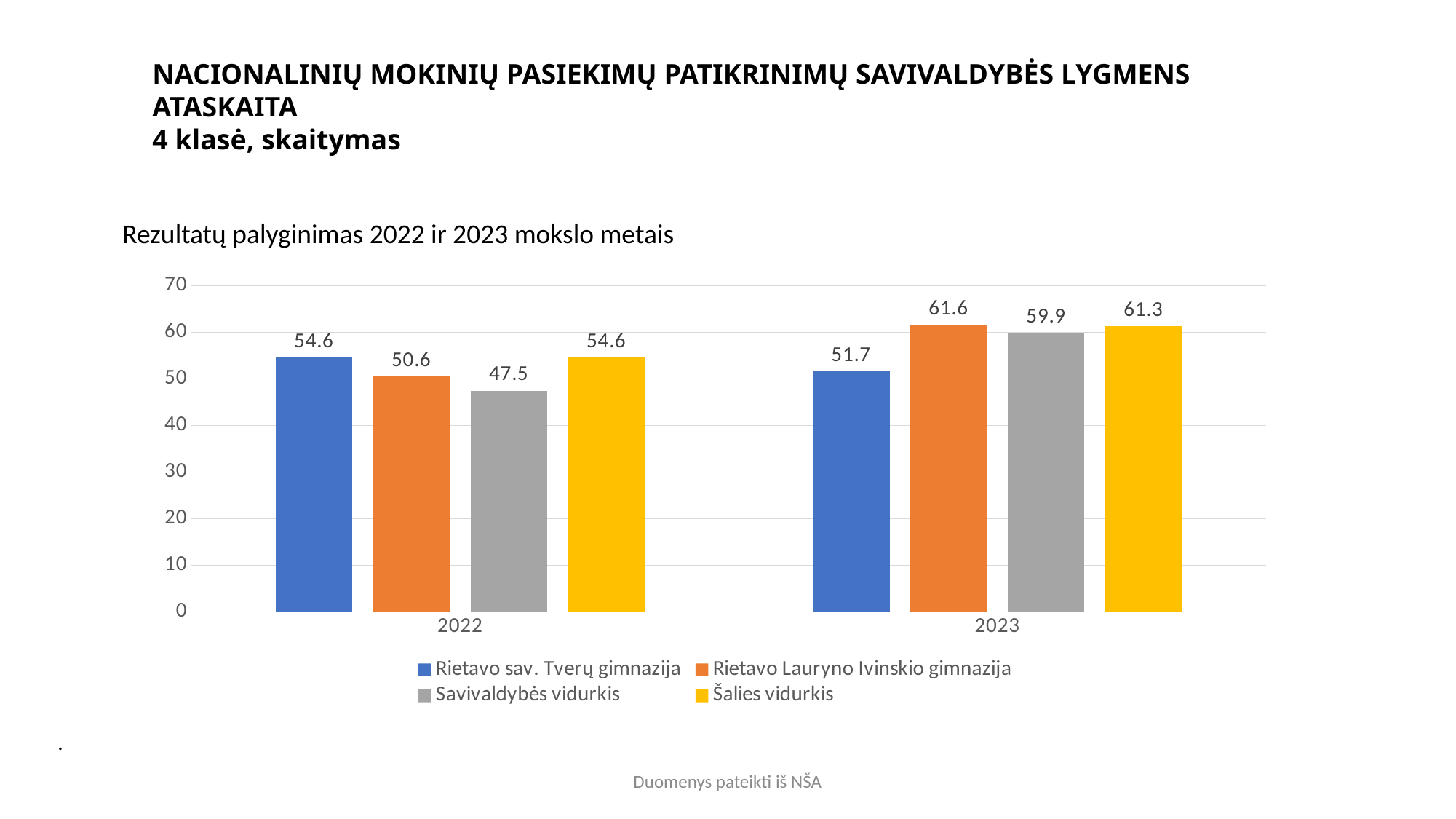
Does the value for Šalies vidurkis rise or fall from 2022 to 2023? Rise What is the value for Savivaldybės vidurkis in 2023? 59.9 Which is larger in 2022: Rietavo sav. Tverų gimnazija or Rietavo Lauryno Ivinskio gimnazija? Rietavo sav. Tverų gimnazija What is the value for Rietavo sav. Tverų gimnazija in 2022? 54.6 What is the difference between Rietavo Lauryno Ivinskio gimnazija and Rietavo sav. Tverų gimnazija in 2023? 9.9 How many series does the legend list? 4 Which series has the lowest value in 2023? Rietavo sav. Tverų gimnazija What is the difference between the 2023 and 2022 values for Savivaldybės vidurkis? 12.4 What is the value for Rietavo Lauryno Ivinskio gimnazija in 2022? 50.6 How many year categories are shown on the x axis? 2 What kind of chart is shown on the slide? Bar chart Which series has the lowest value in 2022? Savivaldybės vidurkis